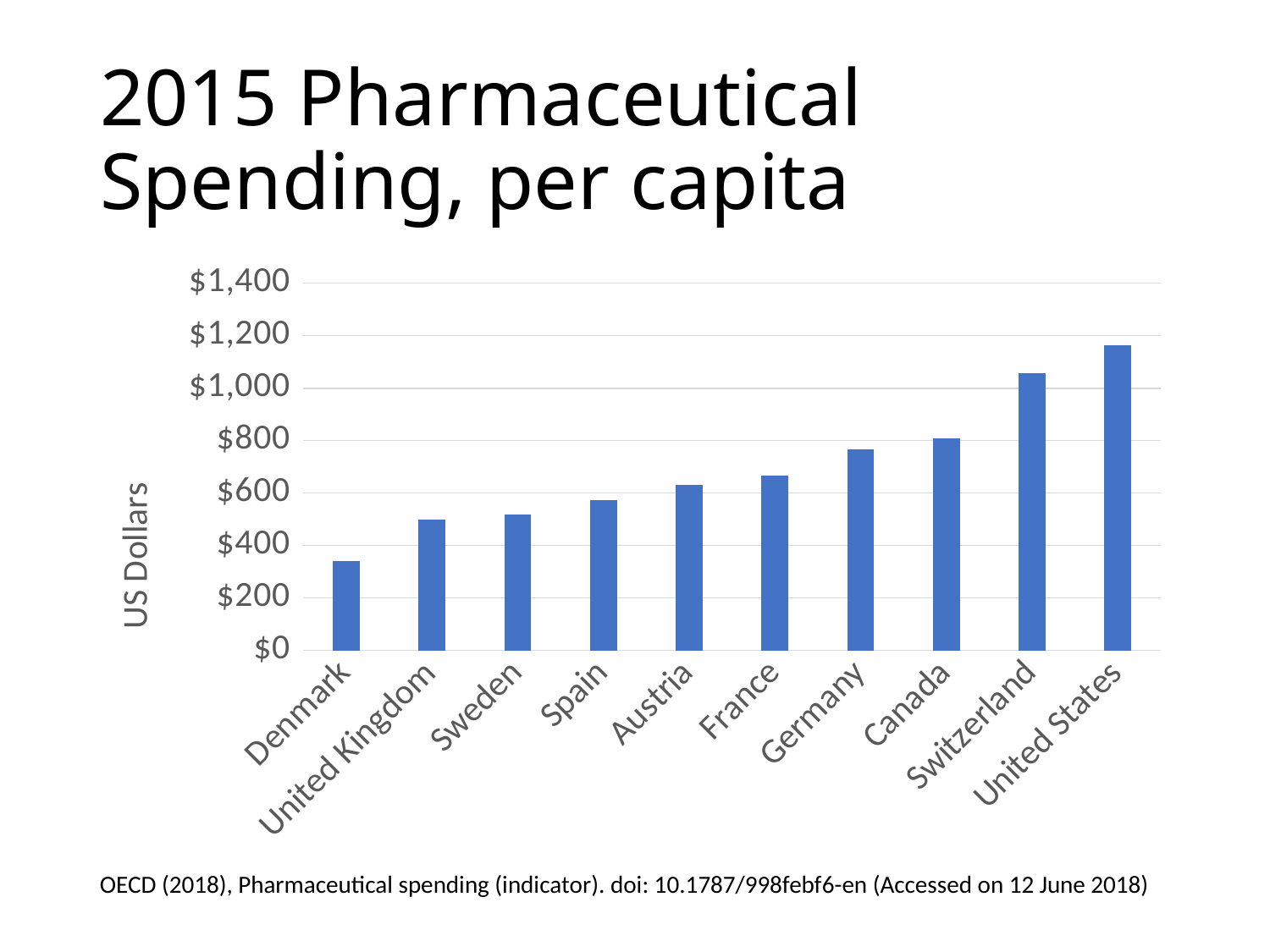
How many countries are shown in the chart? 10 Is the value for Denmark greater or less than $400? less What is the label on the vertical axis of the chart? US Dollars What kind of chart is shown on the slide? Bar chart Which has higher per capita pharmaceutical spending, Switzerland or Canada? Switzerland Is the value for United States greater or less than $1,200? less Is the value for Austria greater or less than $600? greater Which country has the lowest pharmaceutical spending per capita in the chart? Denmark Which country has the highest pharmaceutical spending per capita in the chart? United States Which has higher per capita pharmaceutical spending, Germany or Spain? Germany